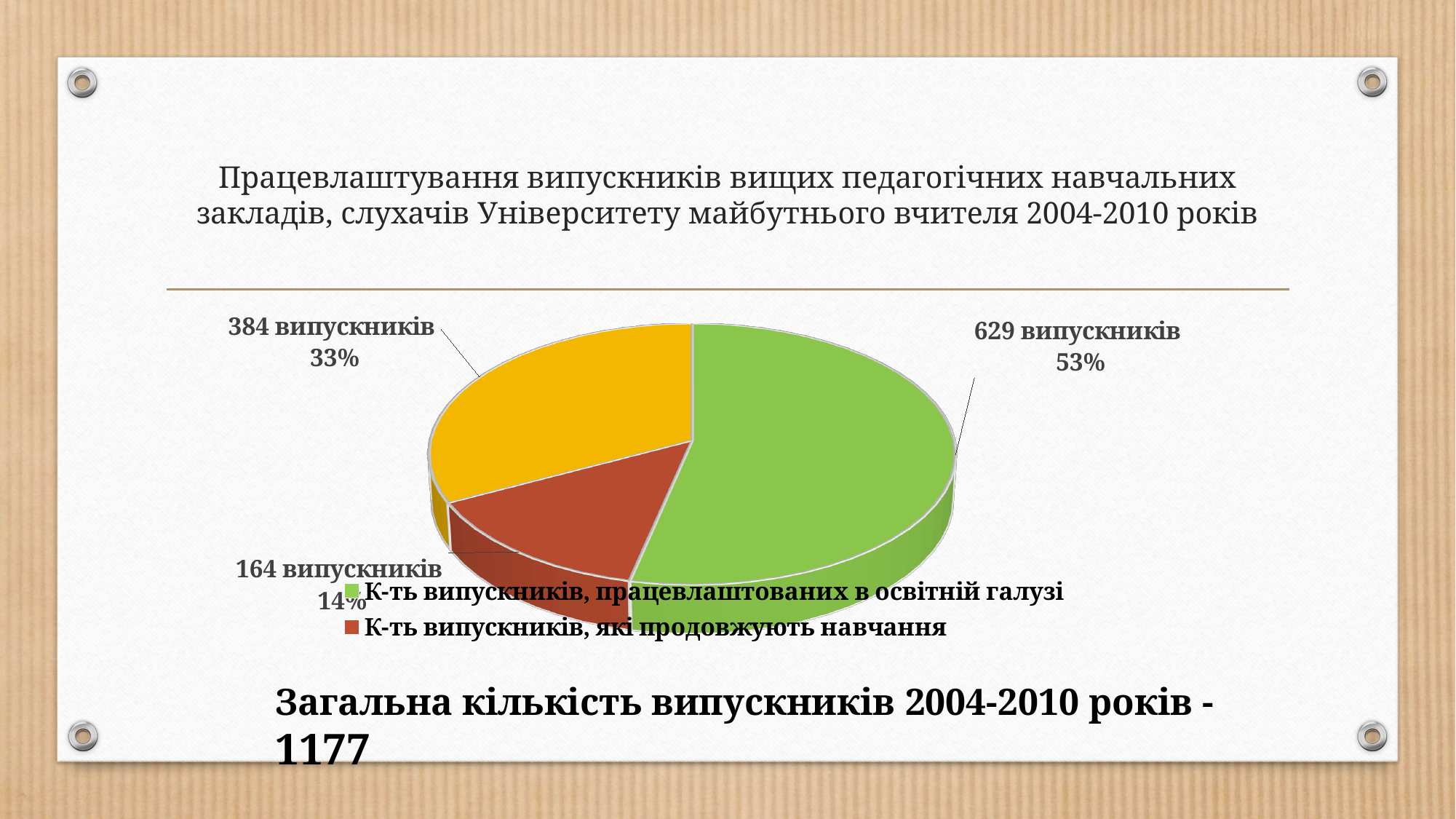
What is the difference between the number of graduates employed in education (629) and those continuing their studies (164)? 465 How many graduates are in the category 'К-ть випускників, які продовжують навчання'? 164 випускників What share of the pie does the category 'К-ть випускників, працевлаштованих в освітній галузі' take? 53% How many graduates are in the category 'К-ть випускників, працевлаштованих в освітній галузі'? 629 випускників How many graduates does the yellow slice represent? 384 випускників What share of the pie does the yellow slice take? 33% Which category has the smallest slice of the pie? К-ть випускників, які продовжують навчання How many slices does the pie chart have? 3 What kind of chart is shown on the slide? pie chart What colour is the slice for 'К-ть випускників, які продовжують навчання'? red What share of the pie does the category 'К-ть випускників, які продовжують навчання' take? 14% Which category has the largest slice of the pie? К-ть випускників, працевлаштованих в освітній галузі